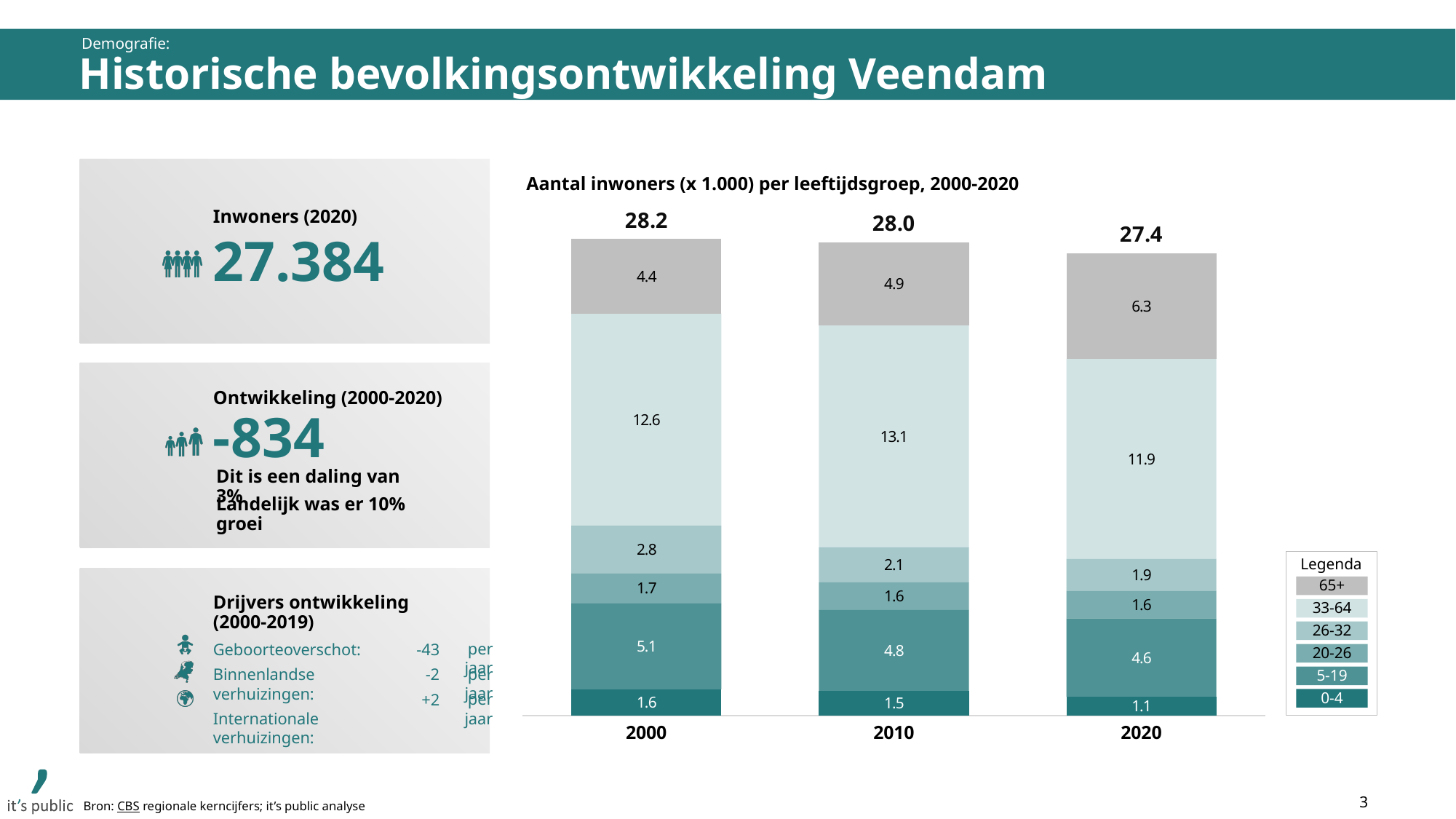
Does the total number of inhabitants rise or fall from 2000 to 2020? Fall What is the value for the 65+ age group in 2020? 6.3 What is the total of the stacked bar for 2020? 27.4 Which year has the highest total number of inhabitants? 2000 How many age groups does the legend list? 6 How many years (categories) are shown on the x axis? 3 What is the difference between the 65+ value in 2020 and in 2000? 1.9 What is the value for the 33-64 age group in 2010? 13.1 Is the 5-19 value larger in 2000 or in 2020? 2000 What is the value for the 0-4 age group in 2000? 1.6 What type of chart is shown on the slide? Stacked bar chart Which year has the lowest value for the 0-4 age group? 2020